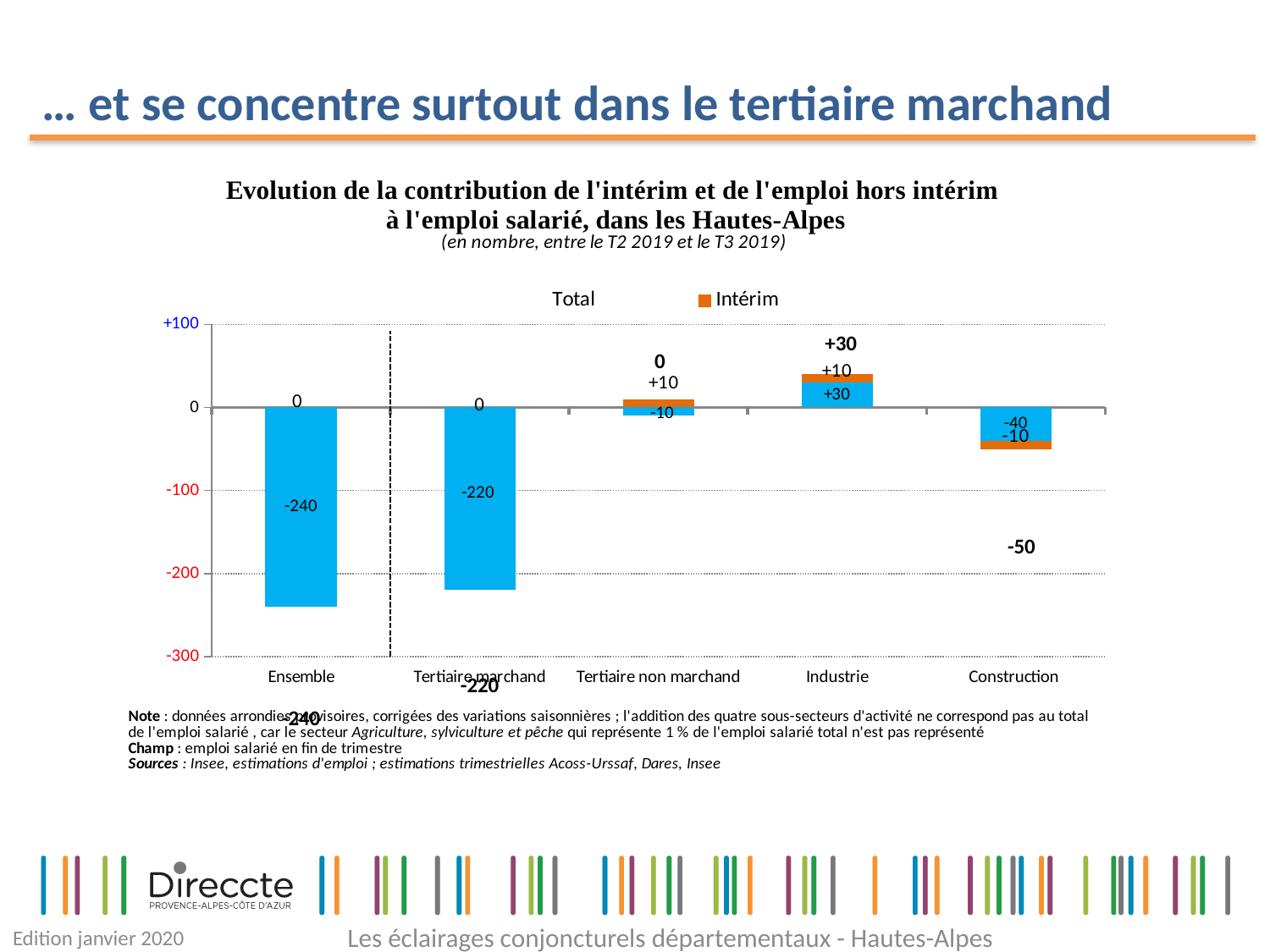
What is the bold total value shown for Construction? -50 What is the Intérim value for Industrie? +10 What is the value of the blue bar for Ensemble? -240 What kind of chart is shown on the slide? bar chart What is the value of the blue bar for Tertiaire marchand? -220 How many categories are shown on the x axis of the chart? 5 What is the difference between the blue bar values for Ensemble and Tertiaire marchand? 20 What is the bold total value shown for Tertiaire non marchand? 0 Which colour represents Intérim in the chart legend? orange Which category has the lowest blue bar value? Ensemble How many entries does the chart legend list? 2 What is the Intérim value for Construction? -10